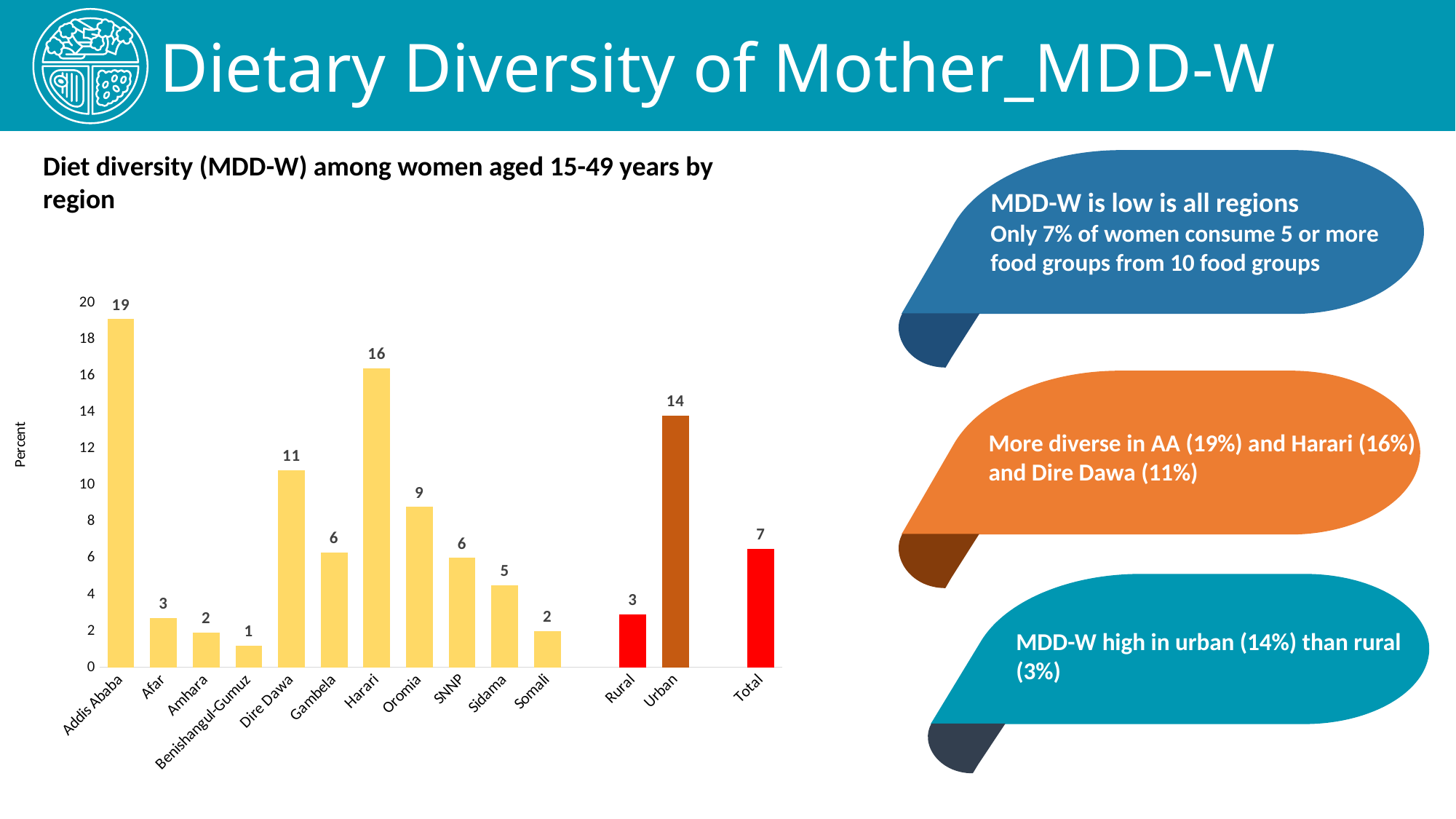
What is the label of the vertical axis? Percent What is the value for Dire Dawa? 11 What is the difference between the Urban and Rural values? 11 Which is larger, the value for Oromia or the value for Sidama? Oromia Is the value for Harari greater or less than 14? greater What is the difference between the Addis Ababa and Harari values? 3 Which region has the highest value? Addis Ababa What is the value for Addis Ababa? 19 How many bars are shown in the chart? 14 What kind of chart is shown on the slide? Bar chart What is the value for Urban? 14 Which category has the lowest value? Benishangul-Gumuz